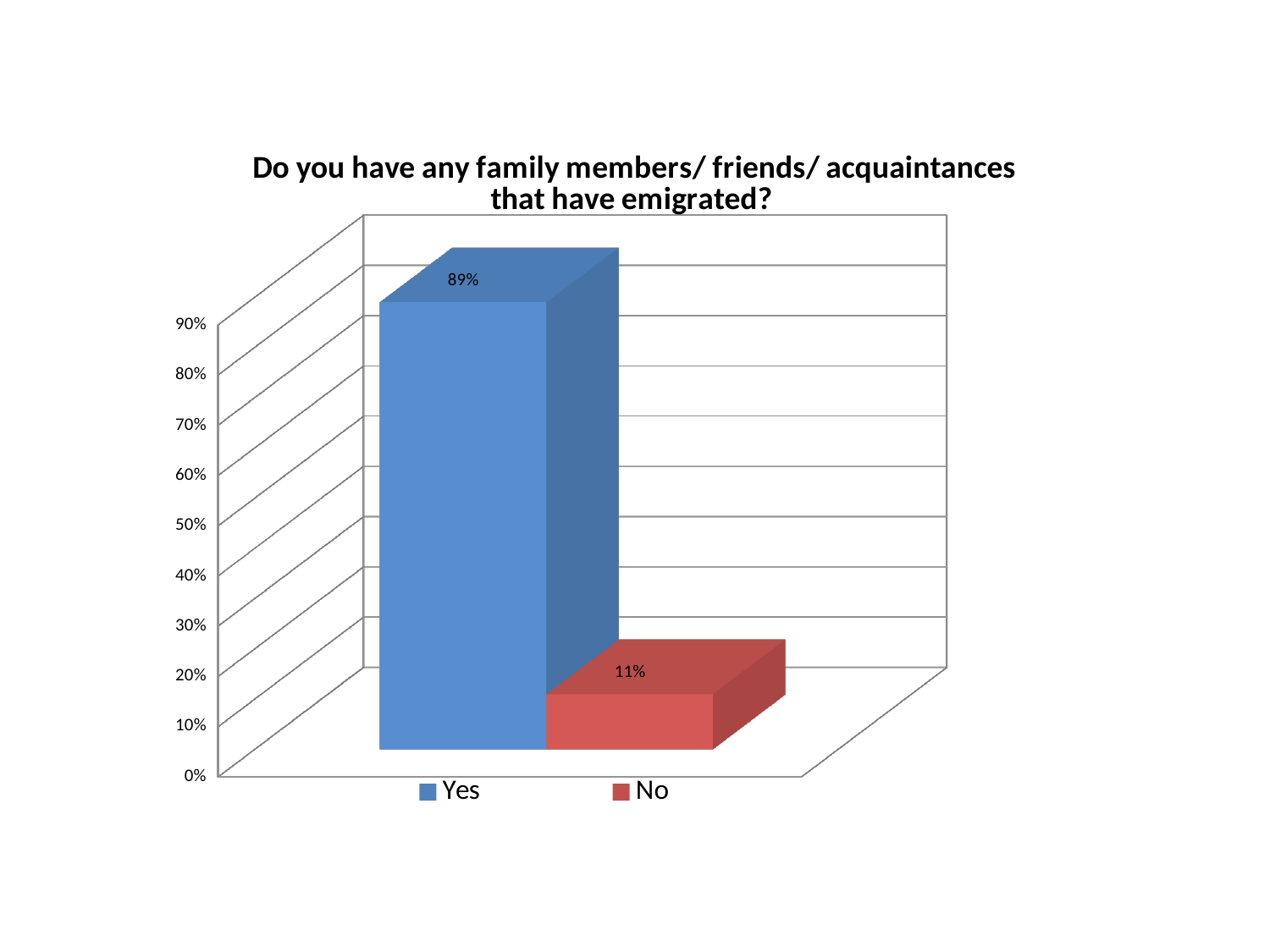
Is the value for Yes greater or less than 50%? greater What is the difference between the Yes and No percentages? 78% How many entries does the legend list? 2 Is the value for No greater or less than 20%? less What colour is the bar for No? Red What type of chart is shown on the slide? Bar chart Which response has the lowest value? No Which response has the higher value, Yes or No? Yes What is the title of the chart? Do you have any family members/ friends/ acquaintances that have emigrated? How many response categories are shown in the chart? 2 What percentage of respondents answered Yes? 89% What percentage of respondents answered No? 11%